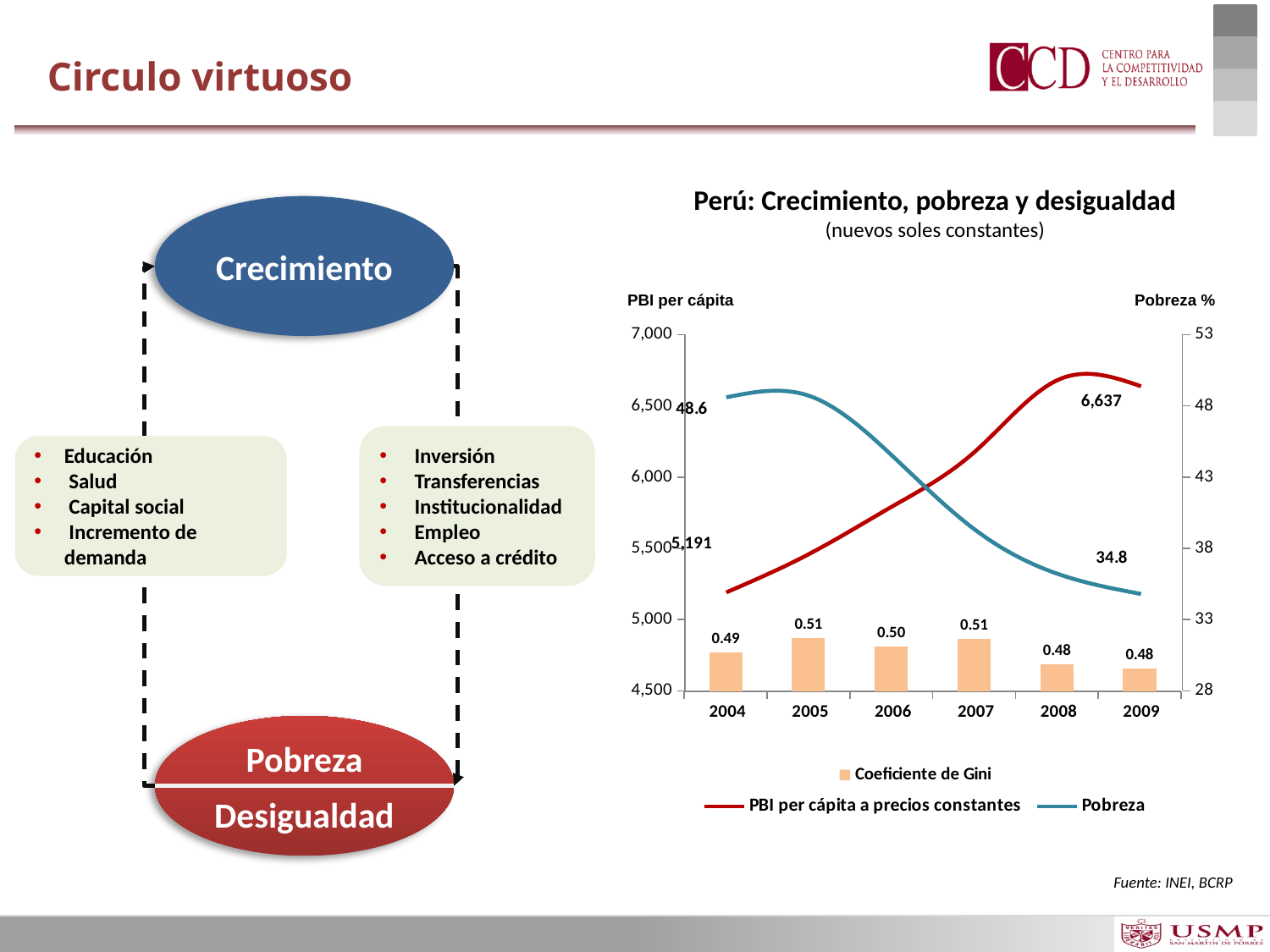
Does the Pobreza line rise or fall from 2004 to 2009? fall Is the Coeficiente de Gini for 2006 larger or smaller than for 2007? smaller How many years are shown on the x axis? 6 What is the Coeficiente de Gini value shown for 2005? 0.51 By how much did the labelled Pobreza value fall from 2004 to 2009? 13.8 How many series does the legend list? 3 What PBI per cápita value is labelled for 2009? 6,637 What is the difference between the PBI per cápita labels for 2009 and 2004? 1,446 What Pobreza value is labelled for 2004? 48.6 Which year has the lowest Coeficiente de Gini bar? 2008 and 2009 (0.48) What Pobreza value is labelled for 2009? 34.8 What is the Coeficiente de Gini value shown for 2008? 0.48